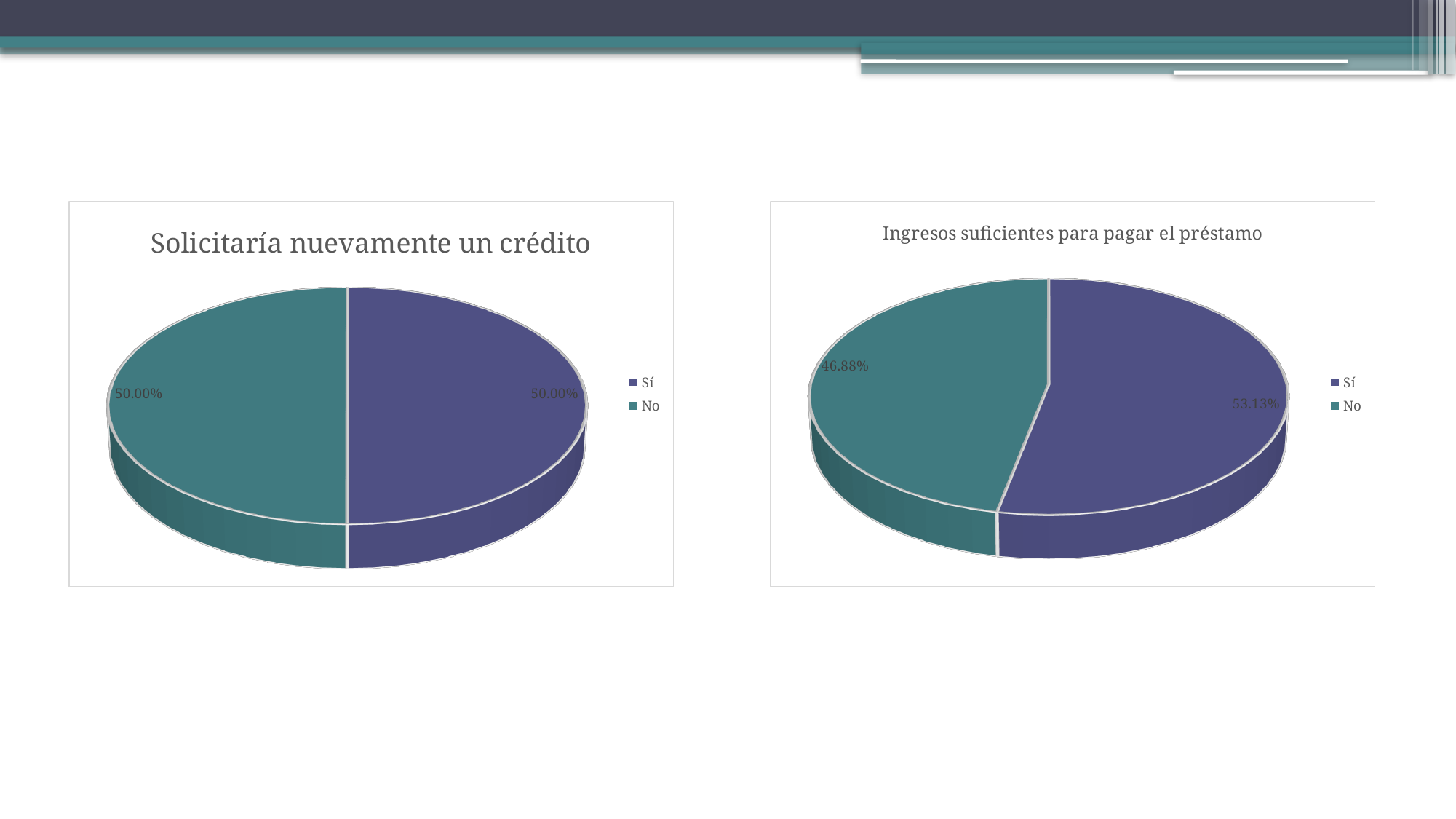
In the chart titled "Solicitaría nuevamente un crédito", what share of the pie is labelled "Sí"? 50.00% In the chart titled "Ingresos suficientes para pagar el préstamo", is the "Sí" slice larger or smaller than the "No" slice? larger In the chart titled "Ingresos suficientes para pagar el préstamo", what is the difference between the "Sí" and "No" shares? 6.25% What kind of chart is the one titled "Solicitaría nuevamente un crédito"? pie chart In the chart titled "Ingresos suficientes para pagar el préstamo", which category has the largest slice? Sí In the chart titled "Ingresos suficientes para pagar el préstamo", which category has the smallest slice? No How many entries does the legend of the chart titled "Solicitaría nuevamente un crédito" list? 2 What is the title of the chart on the right side of the slide? Ingresos suficientes para pagar el préstamo In the chart titled "Ingresos suficientes para pagar el préstamo", what share of the pie is labelled "No"? 46.88% In the chart titled "Ingresos suficientes para pagar el préstamo", what share of the pie is labelled "Sí"? 53.13% How many categories does the chart titled "Ingresos suficientes para pagar el préstamo" show? 2